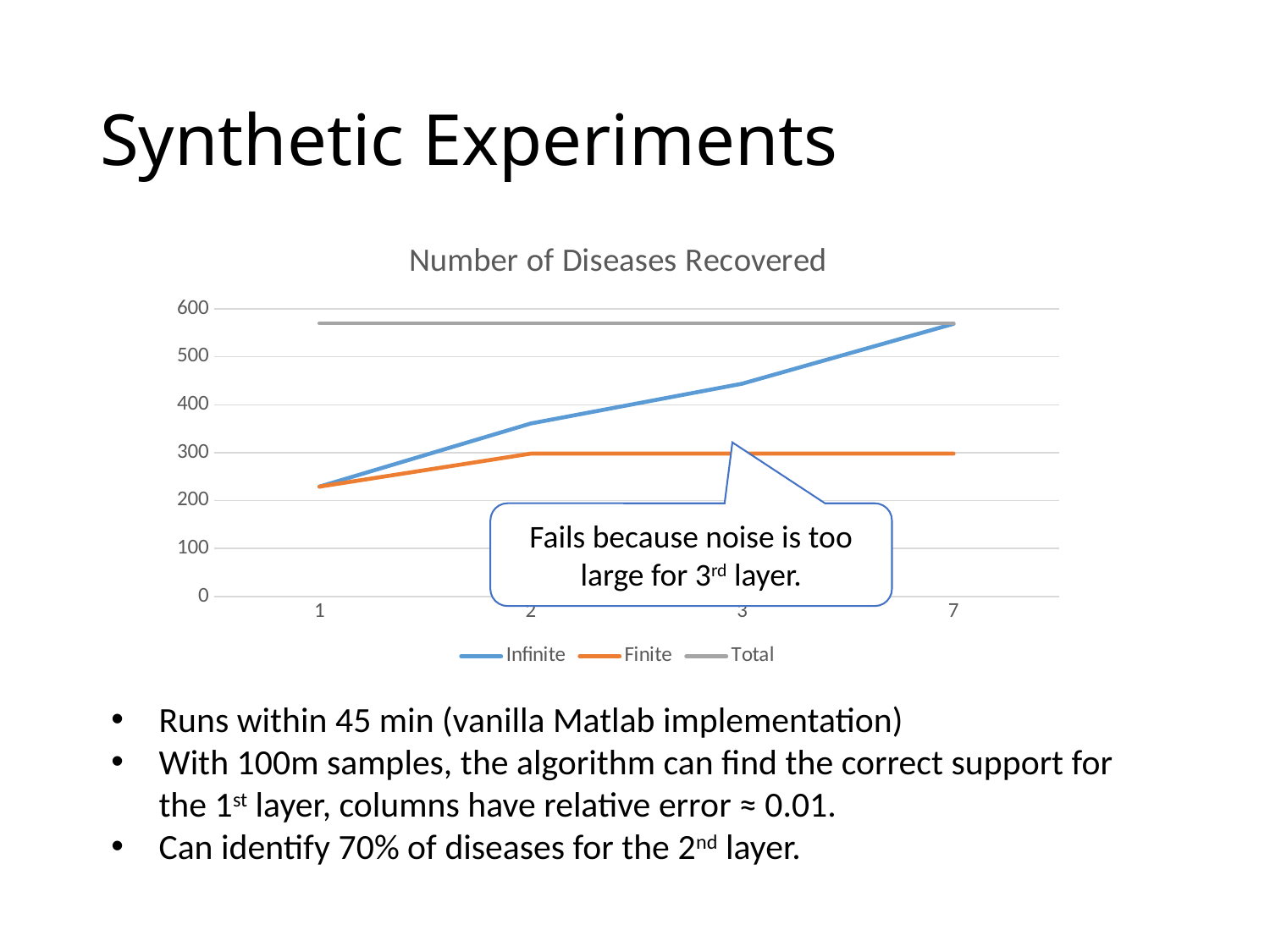
What is the title of the chart? Number of Diseases Recovered Does the Infinite series rise or fall along the x axis? rise At x = 7, which series has the lowest value? Finite Is the value of the Infinite series at x = 1 greater or less than 300? less Is the value of the Infinite series at x = 7 greater or less than 500? greater How many series does the legend list? 3 At x = 3, which series has the larger value, Infinite or Finite? Infinite Is the value of the Finite series at x = 3 greater or less than 400? less What kind of chart is shown on the slide? line chart How many points are on the x axis of the chart? 4 What are the series names listed in the legend? Infinite, Finite, Total